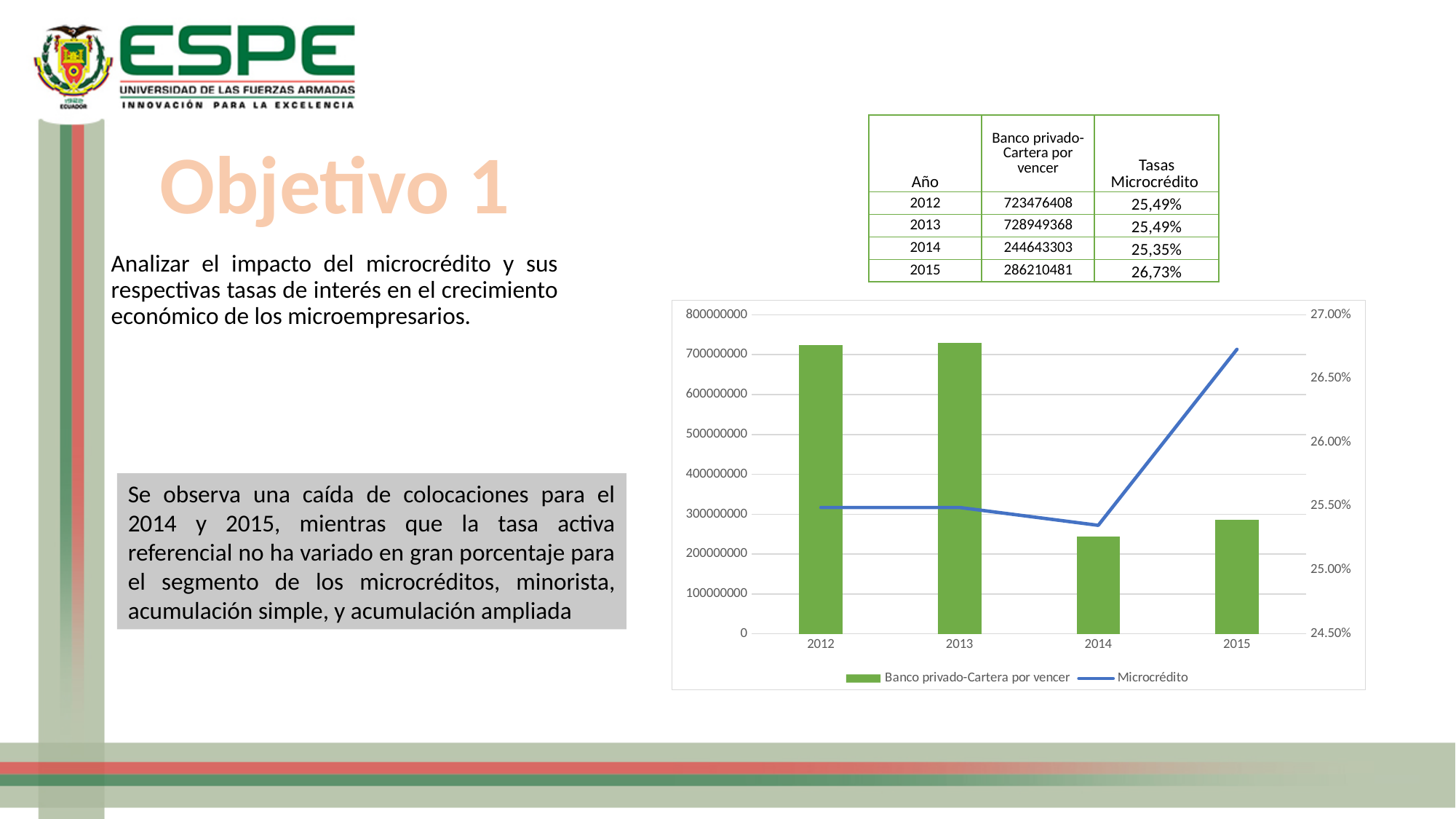
Which year has the lowest Banco privado-Cartera por vencer bar? 2014 Which year has the lowest Microcrédito rate? 2014 Which year has the highest Microcrédito rate? 2015 What is the value of Banco privado-Cartera por vencer for 2012? 723476408 Is the Banco privado-Cartera por vencer value for 2014 greater or less than 300000000? less Which is larger, the Banco privado-Cartera por vencer value for 2015 or for 2014? 2015 What is the difference between the Banco privado-Cartera por vencer values for 2015 and 2014? 41567178 How many series does the chart legend list? 2 What is the Microcrédito rate for 2015? 26,73% What is the Microcrédito rate for 2014? 25,35% Is the Banco privado-Cartera por vencer value for 2012 greater or less than 700000000? greater How many years are shown on the x axis of the chart? 4